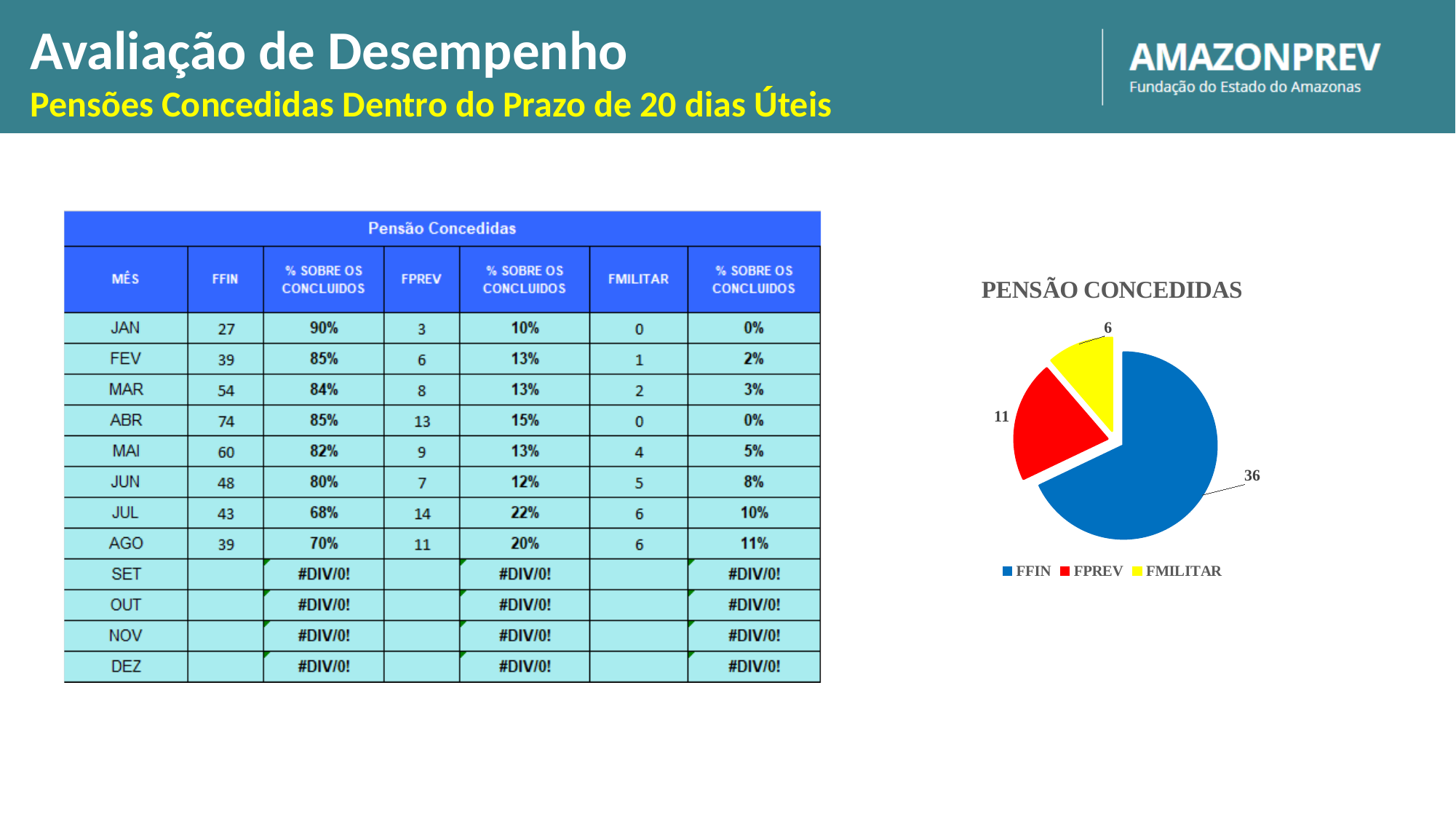
Which category has the largest slice in the pie chart? FFIN In the pie chart, what is the value for FPREV? 11 How many slices does the pie chart have? 3 Which is larger in the pie chart, FPREV or FMILITAR? FPREV What is the difference between the FPREV and FMILITAR values in the pie chart? 5 What is the difference between the FFIN and FPREV values in the pie chart? 25 What type of chart is shown on the slide? pie chart What is the title of the chart? PENSÃO CONCEDIDAS In the pie chart, what is the value for FMILITAR? 6 What colour is the FMILITAR slice in the pie chart? yellow Which category has the smallest slice in the pie chart? FMILITAR In the pie chart, what is the value for FFIN? 36